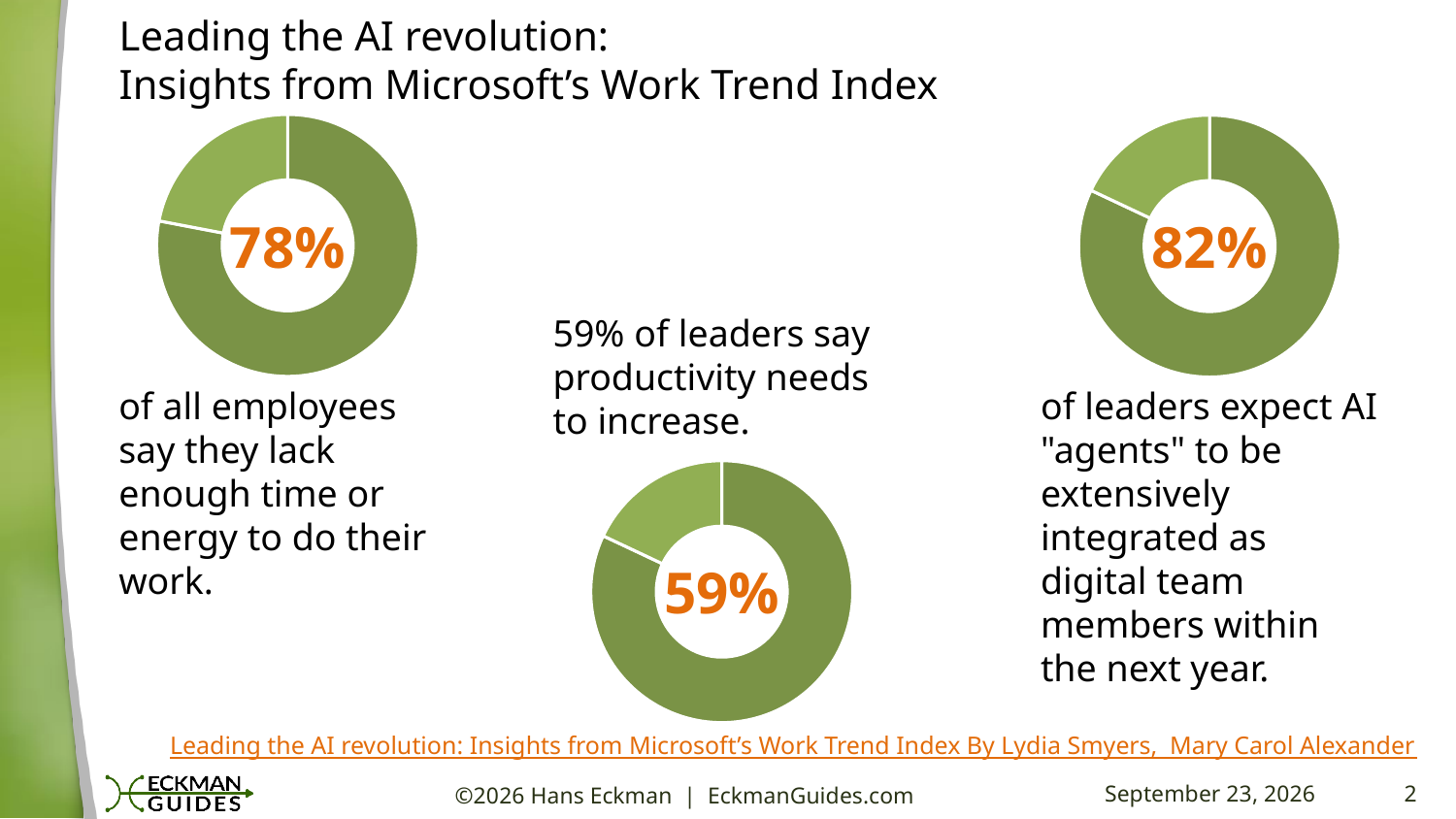
What kind of chart is used to show the percentages on this slide? Doughnut (pie) chart In the middle chart, what percentage of leaders say productivity needs to increase? 59% How many slices does each doughnut chart on the slide have? 2 What is the difference between the percentage in the left chart (78%) and the percentage in the middle chart (59%)? 19 percentage points In the left chart, what percentage of all employees say they lack enough time or energy to do their work? 78% Which is larger: the percentage in the left chart or the percentage in the middle chart? The left chart (78%) What is the difference between the percentage in the right chart (82%) and the percentage in the left chart (78%)? 4 percentage points How many charts are shown on the slide? 3 In the right chart, what percentage of leaders expect AI "agents" to be extensively integrated as digital team members within the next year? 82% Which of the three charts shows the lowest percentage? The middle chart (59%) In the left chart, what share of the ring is taken by the lighter green slice (the remainder not covered by 78%)? 22% Which of the three charts shows the highest percentage? The right chart (82%)